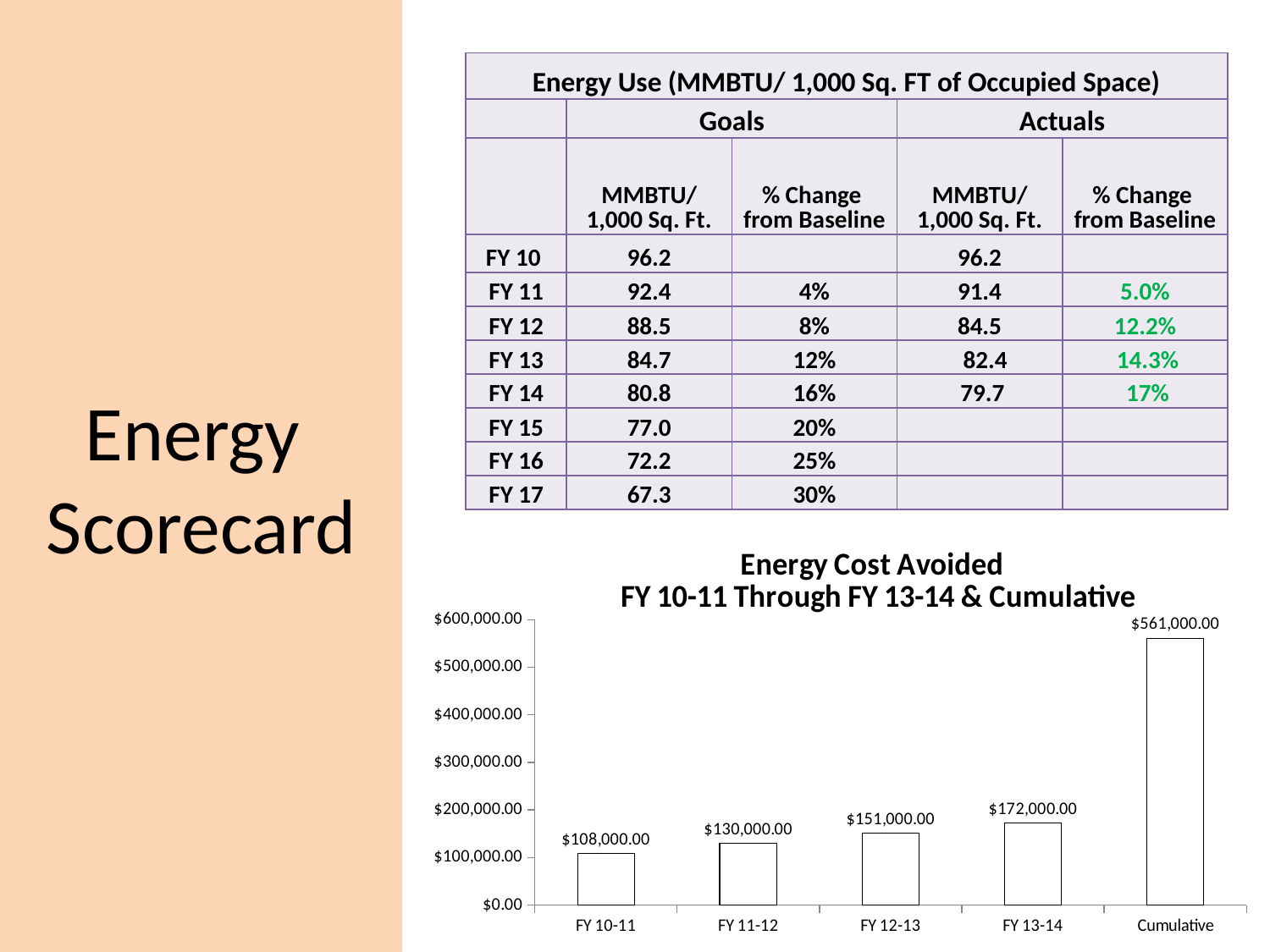
What is the value for FY 12-13 in the Energy Cost Avoided chart? $151,000.00 Is the value for FY 13-14 in the Energy Cost Avoided chart greater or less than $200,000.00? less What is the value for the Cumulative bar in the Energy Cost Avoided chart? $561,000.00 What is the difference between the FY 11-12 and FY 12-13 values in the Energy Cost Avoided chart? $21,000.00 What kind of chart is the Energy Cost Avoided chart? bar chart In the Energy Cost Avoided chart, which is larger: FY 11-12 or FY 13-14? FY 13-14 Which category has the lowest value in the Energy Cost Avoided chart? FY 10-11 What is the difference between the FY 13-14 and FY 10-11 values in the Energy Cost Avoided chart? $64,000.00 What is the value for FY 10-11 in the Energy Cost Avoided chart? $108,000.00 How many bars are shown in the Energy Cost Avoided chart? 5 Which category has the highest value in the Energy Cost Avoided chart? Cumulative Do the values in the Energy Cost Avoided chart rise or fall from FY 10-11 to FY 13-14? rise